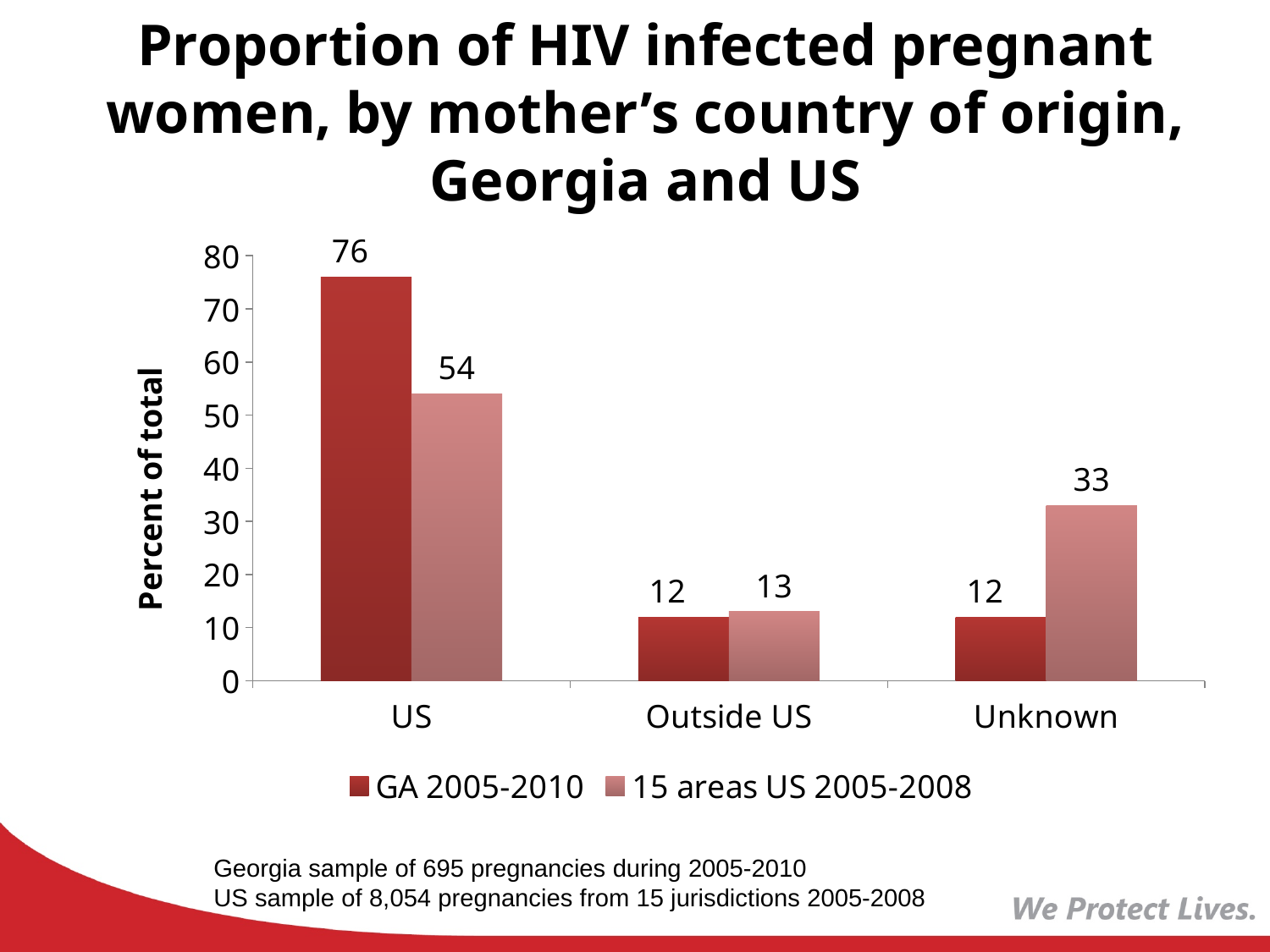
What is the value for Outside US in the 15 areas US 2005-2008 series? 13 What kind of chart is shown on the slide? bar chart What is the label of the y axis? Percent of total What is the difference between the GA 2005-2010 and 15 areas US 2005-2008 values for US? 22 How many categories are shown on the x axis? 3 For the Unknown category, which series has the larger value, GA 2005-2010 or 15 areas US 2005-2008? 15 areas US 2005-2008 What is the difference between the 15 areas US 2005-2008 and GA 2005-2010 values for Unknown? 21 What is the value for Unknown in the 15 areas US 2005-2008 series? 33 What is the value for US in the GA 2005-2010 series? 76 Which category has the highest value in the GA 2005-2010 series? US How many series does the legend list? 2 Which category has the lowest value in the 15 areas US 2005-2008 series? Outside US